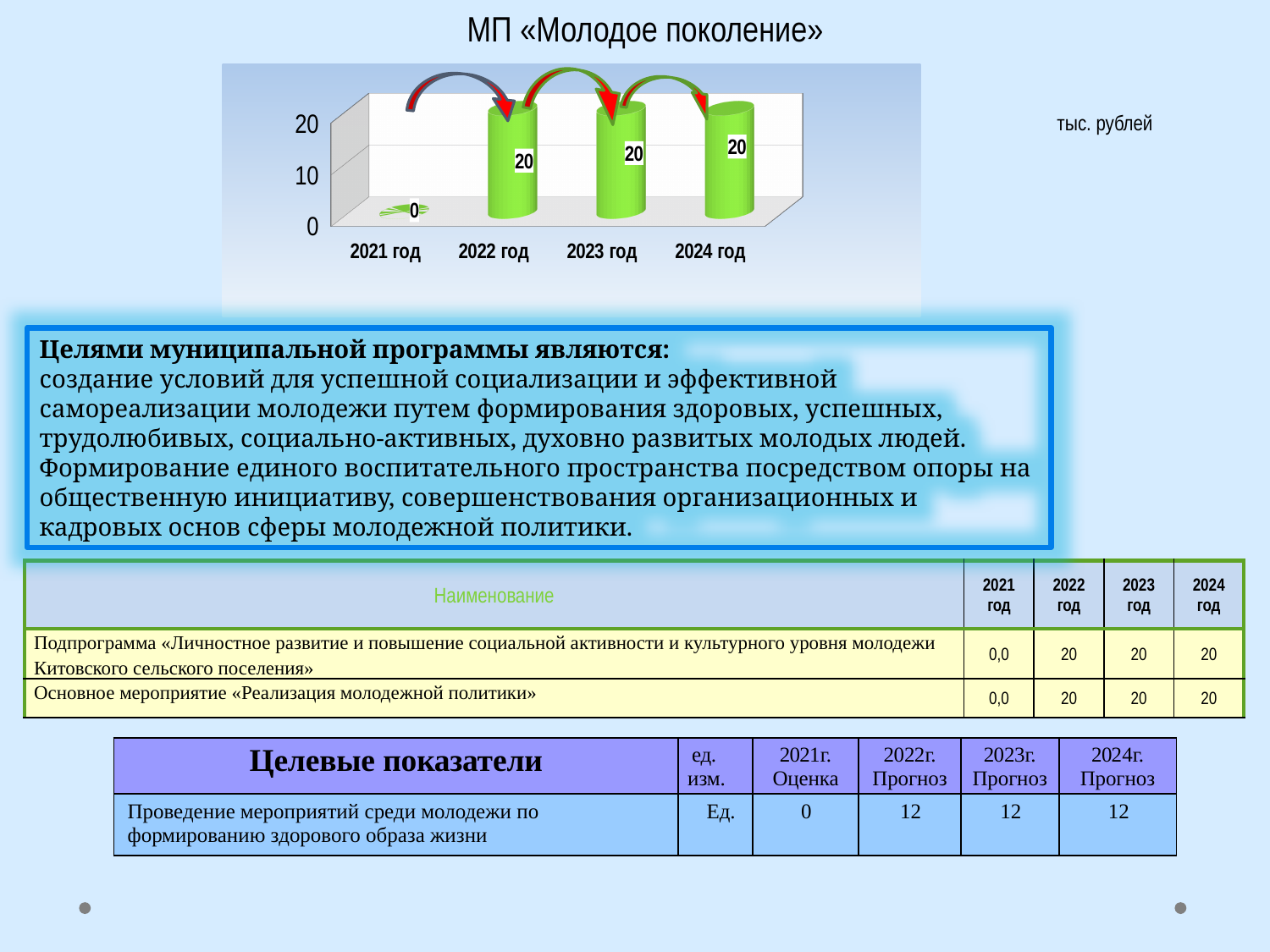
Which year has the lowest value in the chart? 2021 год What is the difference between the values for 2022 год and 2021 год? 20 Is the value for 2023 год greater or less than 10? greater What unit is indicated next to the chart? тыс. рублей What is the value for 2024 год in the chart? 20 Which is larger, the value for 2021 год or the value for 2022 год? 2022 год What is the value for 2023 год in the chart? 20 What kind of chart is shown on the slide? bar chart How many years (categories) are shown in the chart? 4 What is the value for 2021 год in the chart? 0 Do the values rise or fall from 2021 год to 2022 год? rise What is the value for 2022 год in the chart? 20